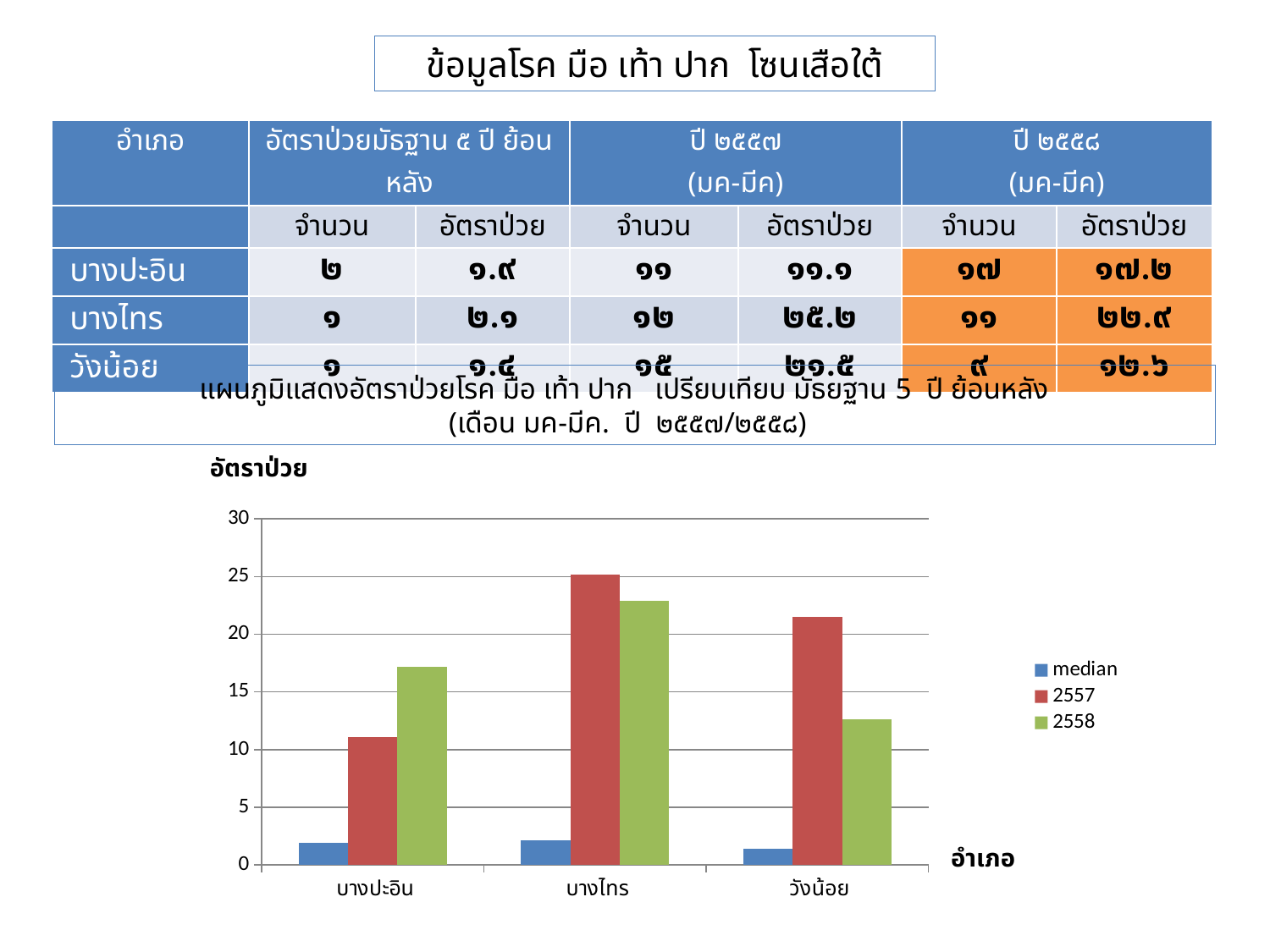
What kind of chart is shown on the slide? bar chart How many series does the chart legend list? 3 For บางปะอิน, which series has the larger value: 2557 or 2558? 2558 What are the three entries listed in the chart legend? median, 2557, 2558 For วังน้อย, which series has the larger value: 2557 or 2558? 2557 Which district has the lowest value for the 2558 series? วังน้อย Which district has the highest value for the 2557 series? บางไทร Is the 2557 value for บางไทร greater or less than 20? greater Is the 2558 value for วังน้อย greater or less than 15? less Is the 2558 value for บางปะอิน greater or less than 15? greater Which district has the lowest value for the 2557 series? บางปะอิน How many districts (categories) are shown on the x axis of the chart? 3